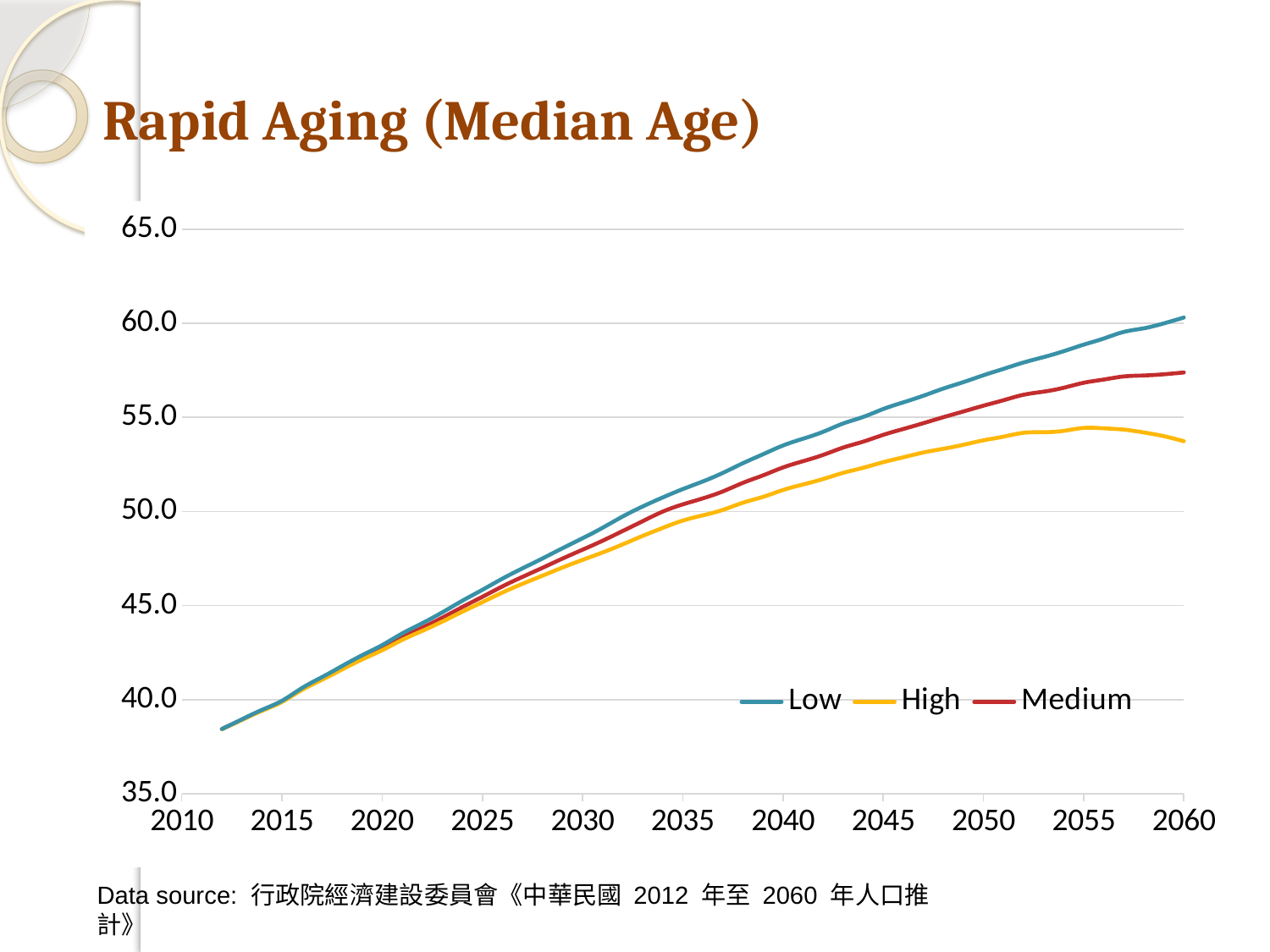
What is the title of the chart? Rapid Aging (Median Age) Is the value of the High series in 2030 greater or less than 45? greater Is the value of the Low series in 2012 greater or less than 40? less Does the Low series rise or fall from 2012 to 2060? rise Which series has the highest value in 2060? Low Is the value of the High series in 2060 greater or less than 55? less Which series has the lowest value in 2060? High What kind of chart is shown on the slide? line chart In 2050, which is larger, the Medium series or the High series? Medium How many series does the legend list? 3 What are the names of the series in the legend? Low, High, Medium